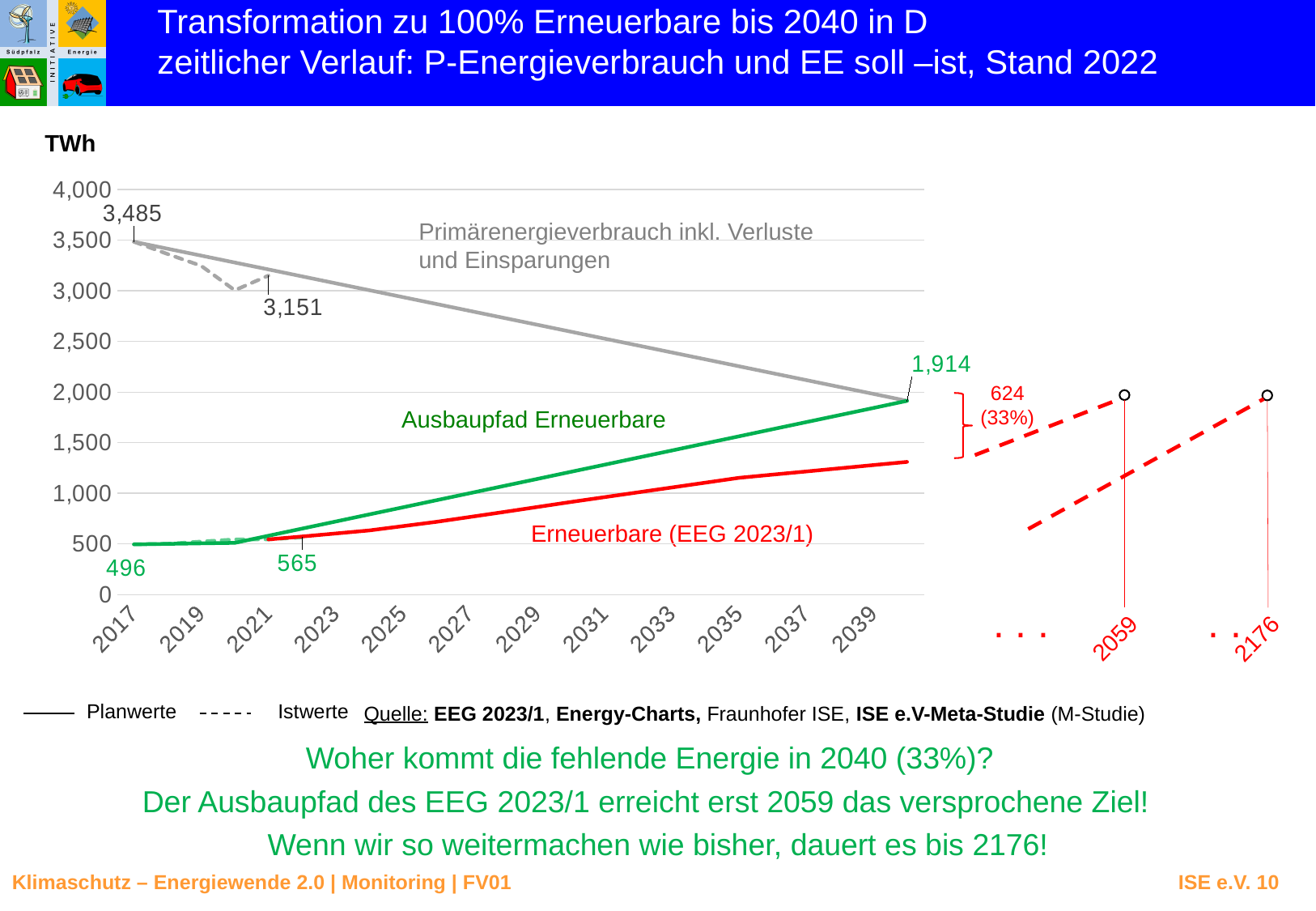
At what value do the Ausbaupfad Erneuerbare line and the Primärenergieverbrauch line meet at the right end of the chart? 1,914 Does the Primärenergieverbrauch line rise or fall from 2017 to 2039? fall What unit is shown above the y axis of the chart? TWh Is the value of the Erneuerbare (EEG 2023/1) line in 2039 greater or less than 1,500? less What Istwert is labelled on the dashed Primärenergieverbrauch line in 2021? 3,151 What is the value of the Primärenergieverbrauch line in 2017? 3,485 What kind of chart is shown on the slide? line chart What is the value of the Ausbaupfad Erneuerbare line in 2017? 496 By how much does the Ausbaupfad Erneuerbare line increase from 2017 (496) to 2021 (565)? 69 In 2039, which line is higher: Ausbaupfad Erneuerbare or Erneuerbare (EEG 2023/1)? Ausbaupfad Erneuerbare What is the difference between the 2017 Primärenergieverbrauch value (3,485) and the 2021 Istwert (3,151)? 334